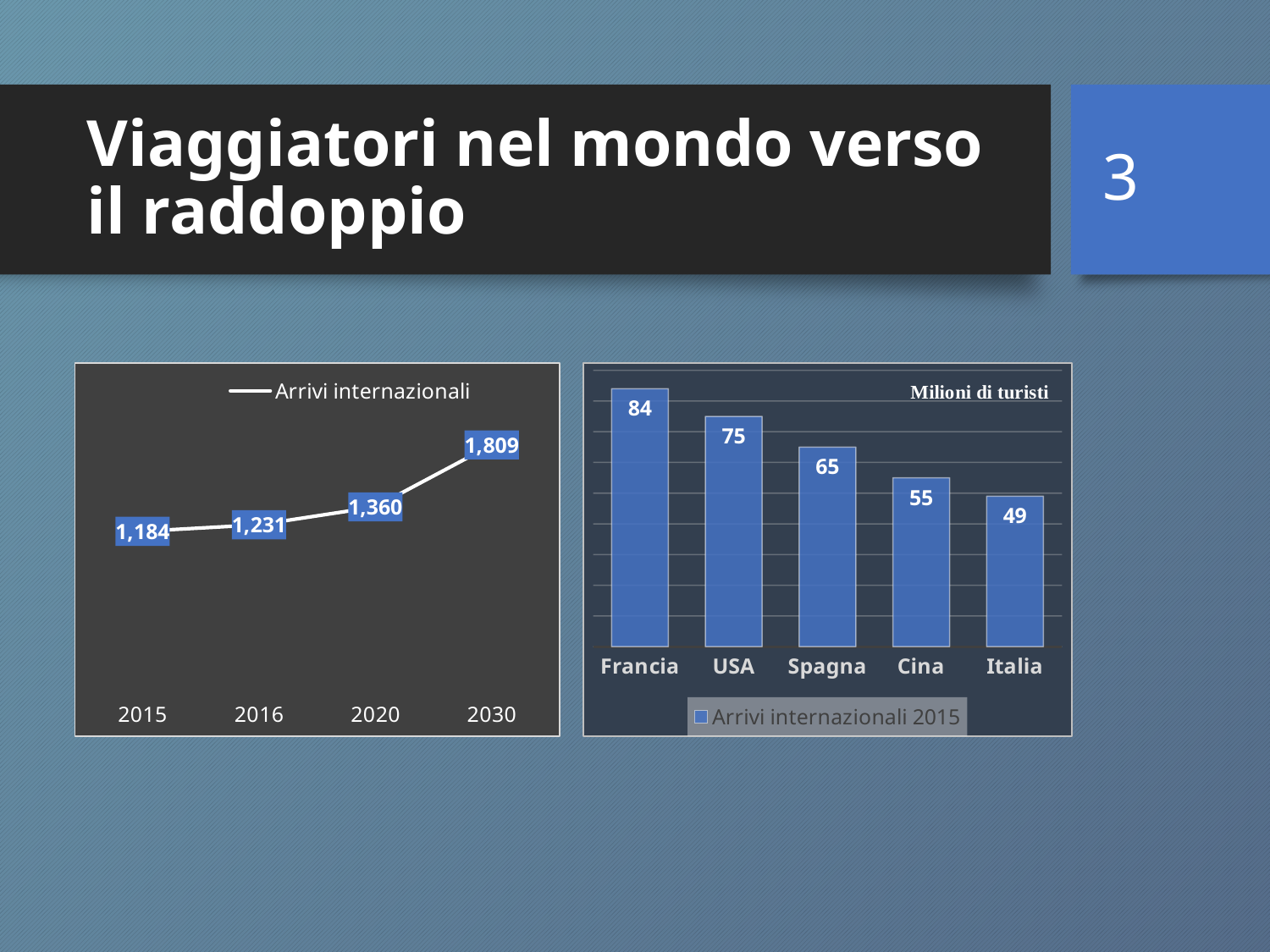
In the left line chart, how many years are plotted on the x axis? 4 What kind of chart is the chart on the left? line chart In the right bar chart, what is the legend entry? Arrivi internazionali 2015 In the right bar chart, which country has the highest value? Francia In the right bar chart, which is larger, the value for Cina or the value for Italia? Cina In the left line chart, what is the value for 2030? 1,809 In the left line chart, what is the difference between the 2030 and 2015 values? 625 In the right bar chart, which country has the lowest value? Italia In the right bar chart, what is the difference between the values for USA and Cina? 20 In the left line chart, do the values rise or fall from 2015 to 2030? rise In the left line chart, what is the value for 2015? 1,184 In the right bar chart, what is the value for Spagna? 65